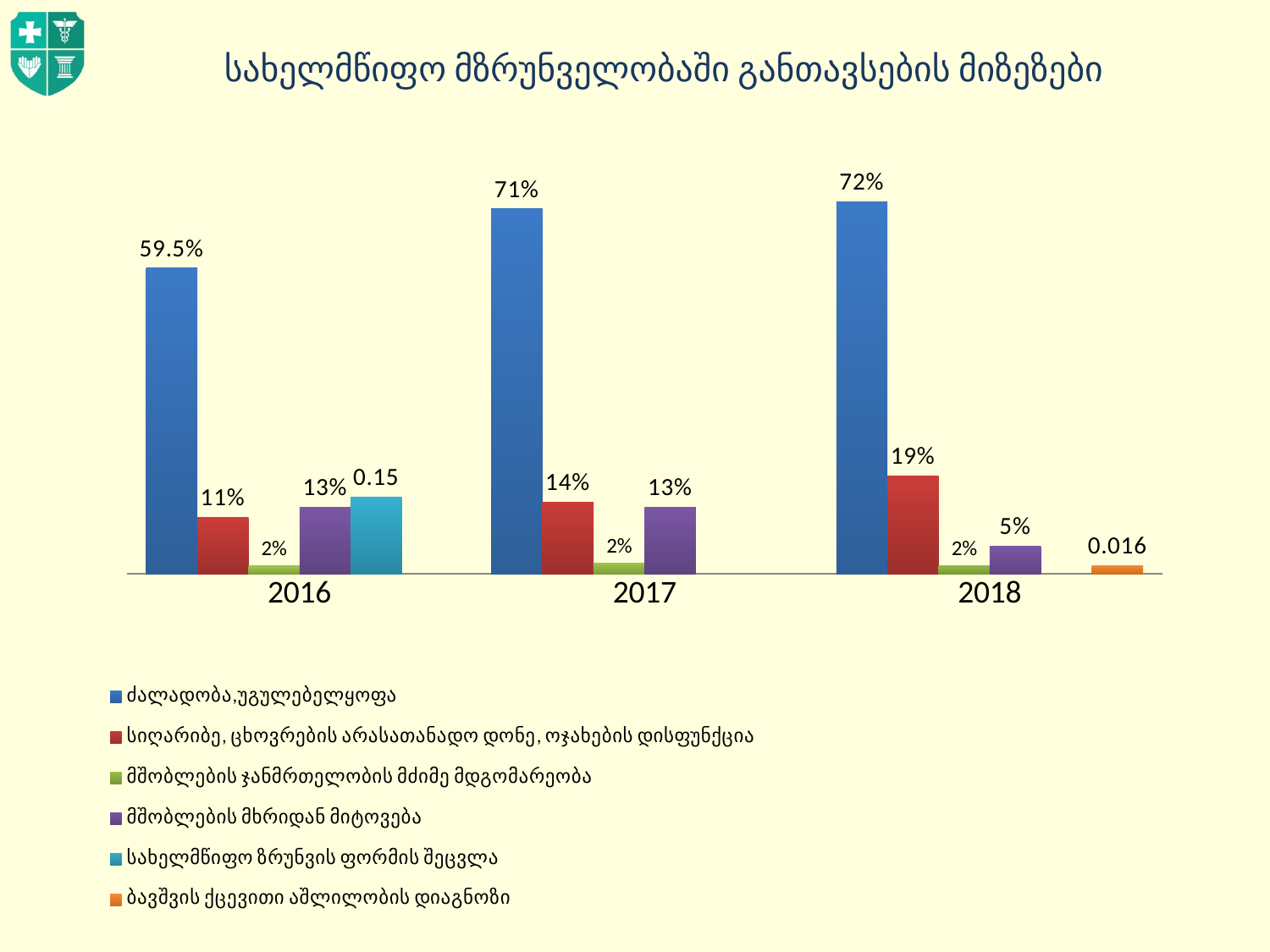
What is the value of the red series (სიღარიბე, ცხოვრების არასათანადო დონე, ოჯახების დისფუნქცია) for 2017? 14% What is the difference between the blue series values for 2017 and 2016? 11.5% In which year is the blue series (ძალადობა,უგულებელყოფა) highest? 2018 What is the value of the blue series (ძალადობა,უგულებელყოფა) for 2018? 72% Which is larger in 2018: the red series (სიღარიბე...) or the purple series (მშობლების მხრიდან მიტოვება)? the red series (სიღარიბე...) In which year is the red series (სიღარიბე, ცხოვრების არასათანადო დონე, ოჯახების დისფუნქცია) lowest? 2016 What is the value of the blue series (ძალადობა,უგულებელყოფა) for 2016? 59.5% How many years are shown on the x axis? 3 How many series does the legend list? 6 What kind of chart is shown on the slide? bar chart What is the value of the orange series (ბავშვის ქცევითი აშლილობის დიაგნოზი) for 2018? 0.016 What is the value of the purple series (მშობლების მხრიდან მიტოვება) for 2018? 5%